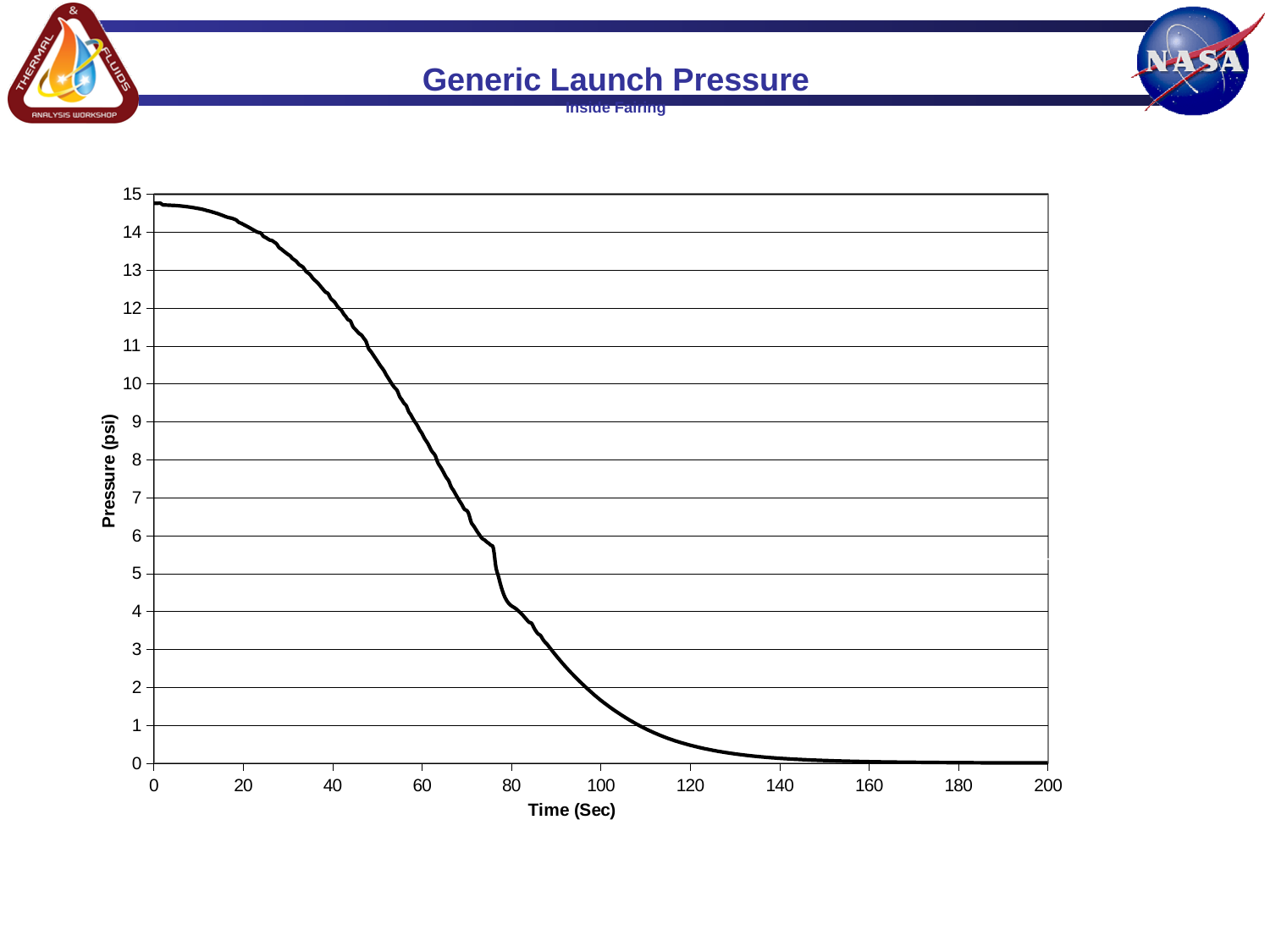
What is the title of the chart's x axis? Time (Sec) Does the pressure rise or fall as time increases along the x axis? fall How many lines are plotted on the chart? 1 What is the title of the chart's y axis? Pressure (psi) What kind of chart is shown on the slide? line chart Is the pressure at 140 seconds greater or less than 1 psi? less At what time on the x axis is the pressure highest? 0 Is the pressure at 60 seconds greater or less than 8 psi? greater Is the pressure at 80 seconds greater or less than 5 psi? less Is the pressure higher at 40 seconds or at 80 seconds? 40 seconds